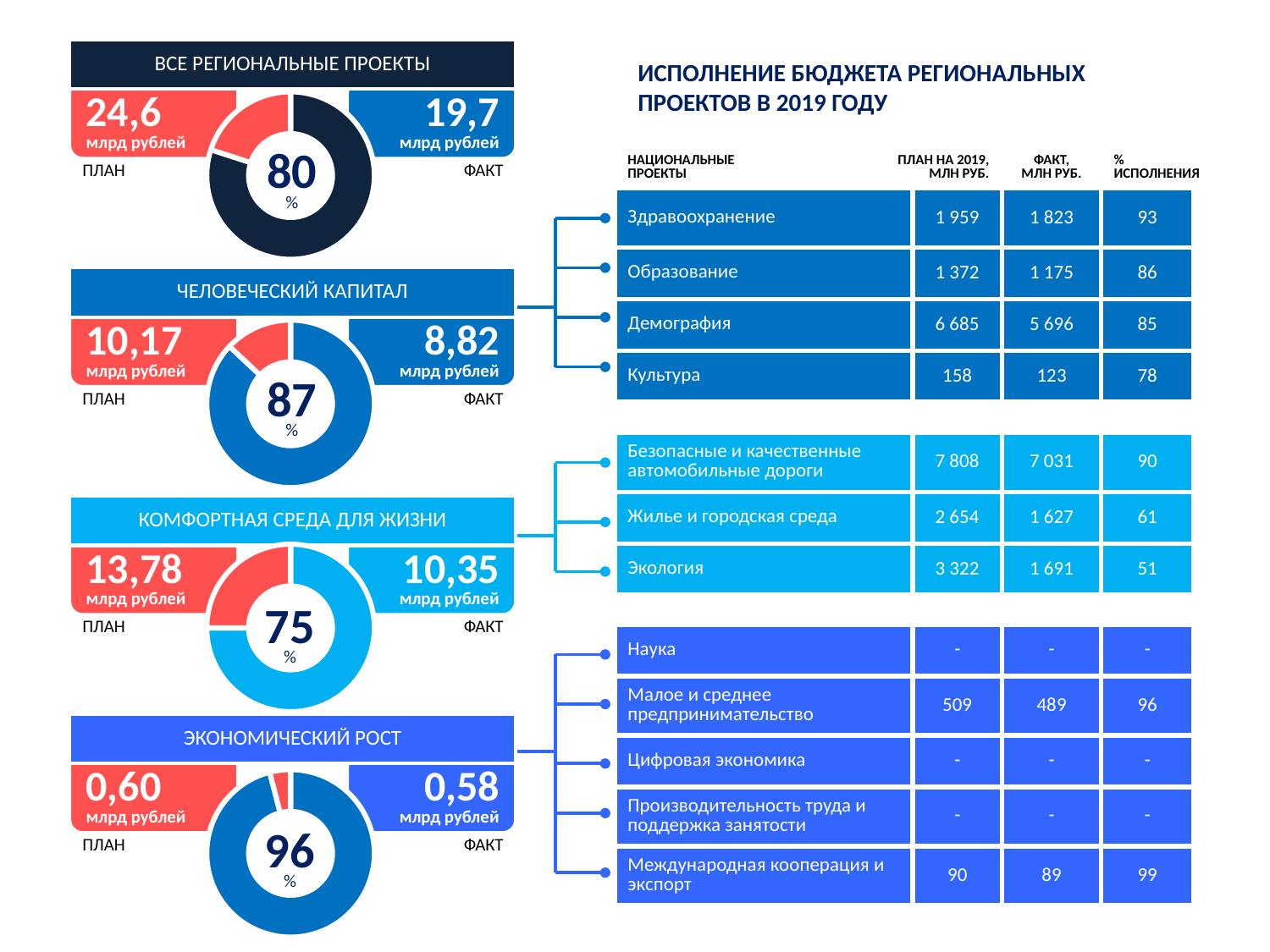
How many donut charts are shown on the slide? 4 In the "ЭКОНОМИЧЕСКИЙ РОСТ" chart, what is the ФАКТ value? 0,58 млрд рублей In the "ВСЕ РЕГИОНАЛЬНЫЕ ПРОЕКТЫ" chart, what is the ФАКТ value? 19,7 млрд рублей Which of the four donut charts shows the lowest percentage in its centre? КОМФОРТНАЯ СРЕДА ДЛЯ ЖИЗНИ In the "ВСЕ РЕГИОНАЛЬНЫЕ ПРОЕКТЫ" chart, what percentage is shown in the centre of the donut? 80% In the "ЧЕЛОВЕЧЕСКИЙ КАПИТАЛ" chart, what is the ФАКТ value? 8,82 млрд рублей In the "ВСЕ РЕГИОНАЛЬНЫЕ ПРОЕКТЫ" chart, what is the ПЛАН value? 24,6 млрд рублей Which of the four donut charts shows the highest percentage in its centre? ЭКОНОМИЧЕСКИЙ РОСТ In the "КОМФОРТНАЯ СРЕДА ДЛЯ ЖИЗНИ" chart, what percentage is shown in the centre of the donut? 75% In the "ЧЕЛОВЕЧЕСКИЙ КАПИТАЛ" chart, what percentage is shown in the centre of the donut? 87% What kind of chart is shown under the heading "ВСЕ РЕГИОНАЛЬНЫЕ ПРОЕКТЫ"? Donut chart In the "КОМФОРТНАЯ СРЕДА ДЛЯ ЖИЗНИ" chart, what is the ПЛАН value? 13,78 млрд рублей